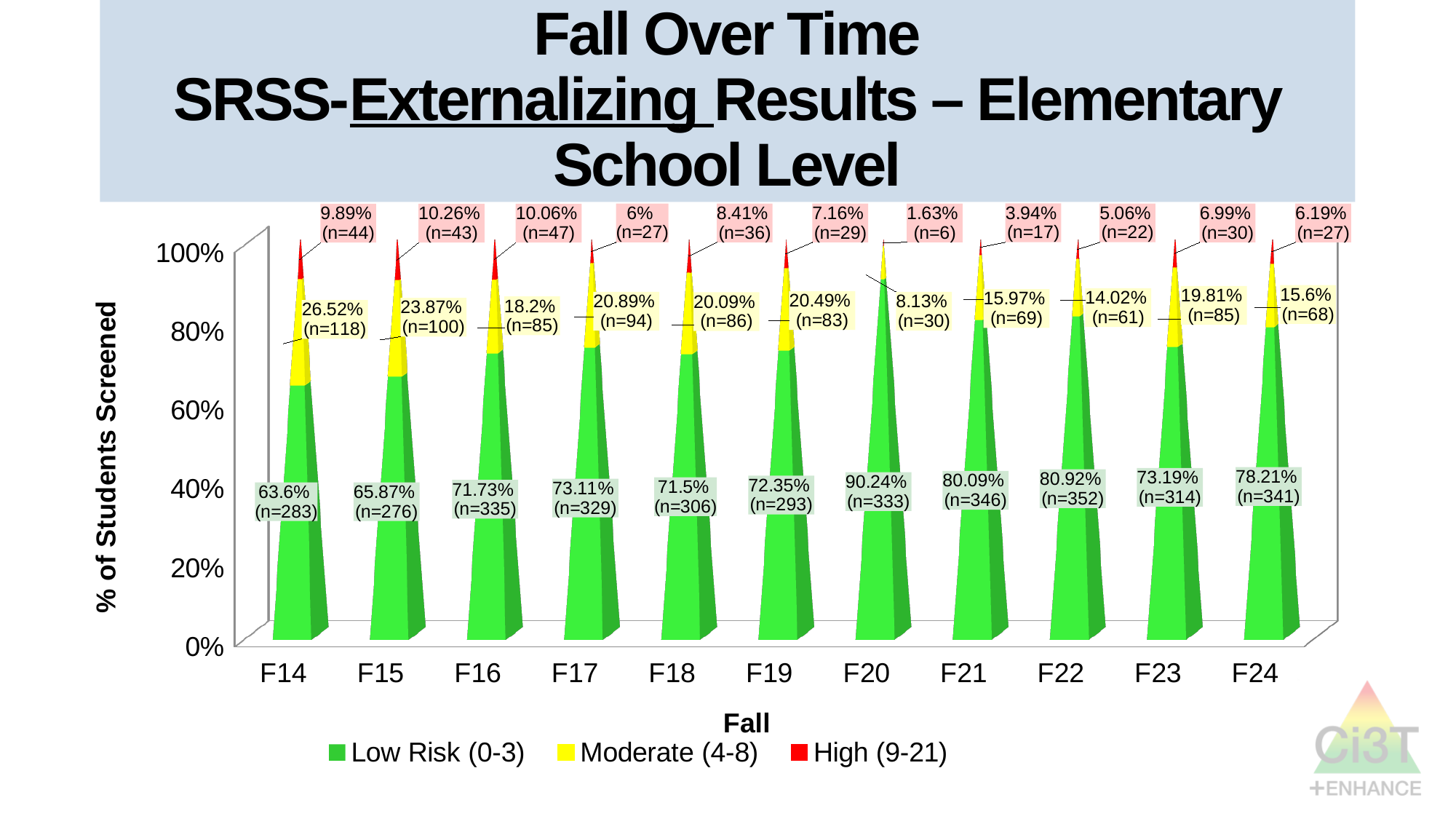
What is the difference in percentage points between the Low Risk (0-3) value in F20 and in F14? 26.64 Which fall has the lowest High (9-21) percentage? F20 Which fall has the highest Low Risk (0-3) percentage? F20 How many series does the legend list? 3 What kind of chart is shown on the slide? Stacked bar chart What percentage of students screened were High (9-21) in F15? 10.26% What is the label of the y axis? % of Students Screened How many fall time points are shown on the x axis? 11 Which fall has the lowest Low Risk (0-3) percentage? F14 How many students were in the Moderate (4-8) category in F24? n=68 What percentage of students screened were Low Risk (0-3) in F20? 90.24% Which has a larger Moderate (4-8) percentage, F14 or F15? F14